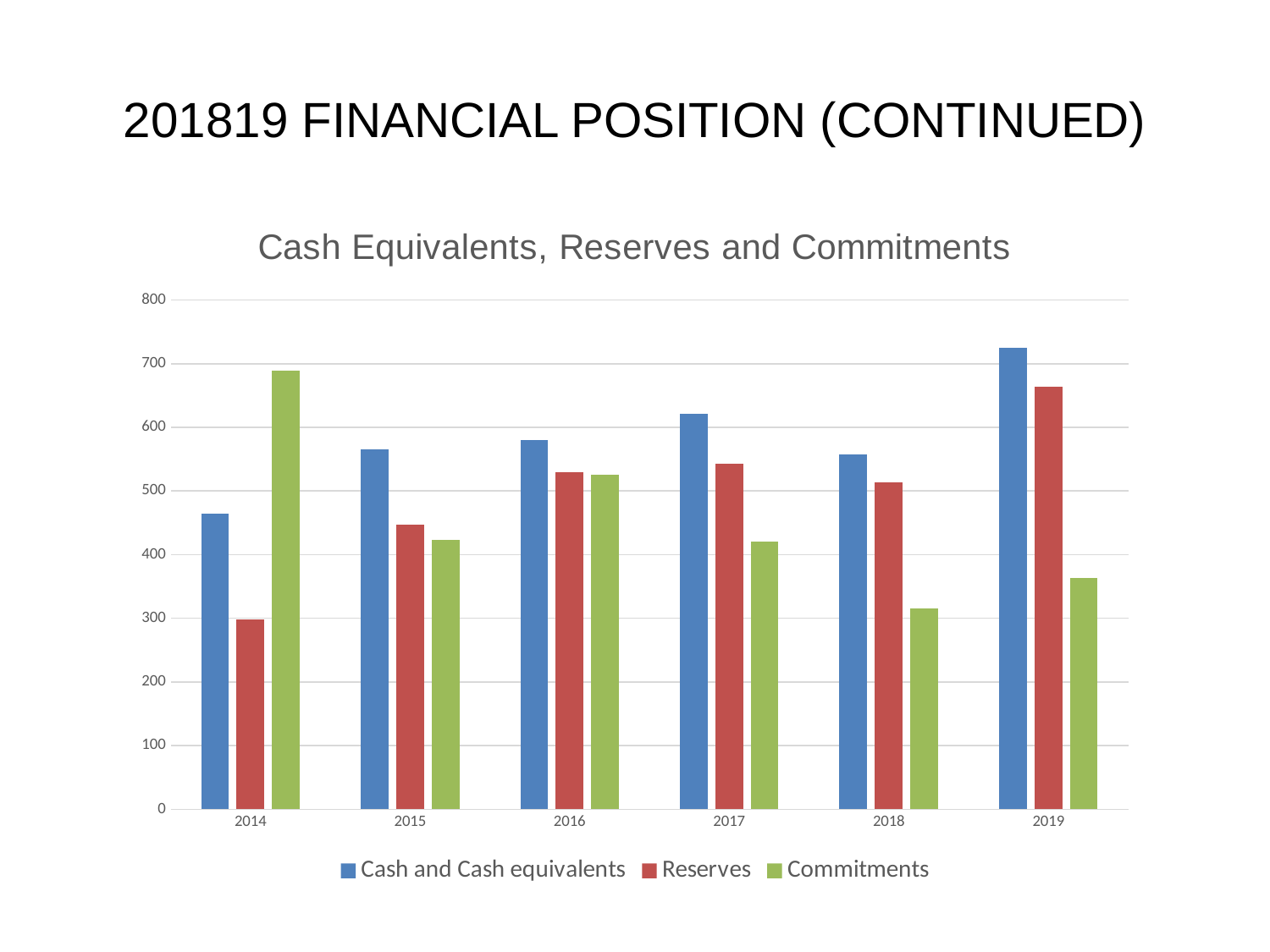
How many series does the legend list? 3 Is the value for Reserves in 2014 greater or less than 400? less In which year is Cash and Cash equivalents highest? 2019 How many years are shown on the x axis? 6 What is the title of the chart? Cash Equivalents, Reserves and Commitments Is the value for Cash and Cash equivalents in 2019 greater or less than 700? greater In which year is Commitments highest? 2014 In which year is Commitments lowest? 2018 In which year is Reserves lowest? 2014 In 2014, which is larger: Cash and Cash equivalents or Commitments? Commitments Is the value for Commitments in 2018 greater or less than 400? less What kind of chart is shown on the slide? bar chart